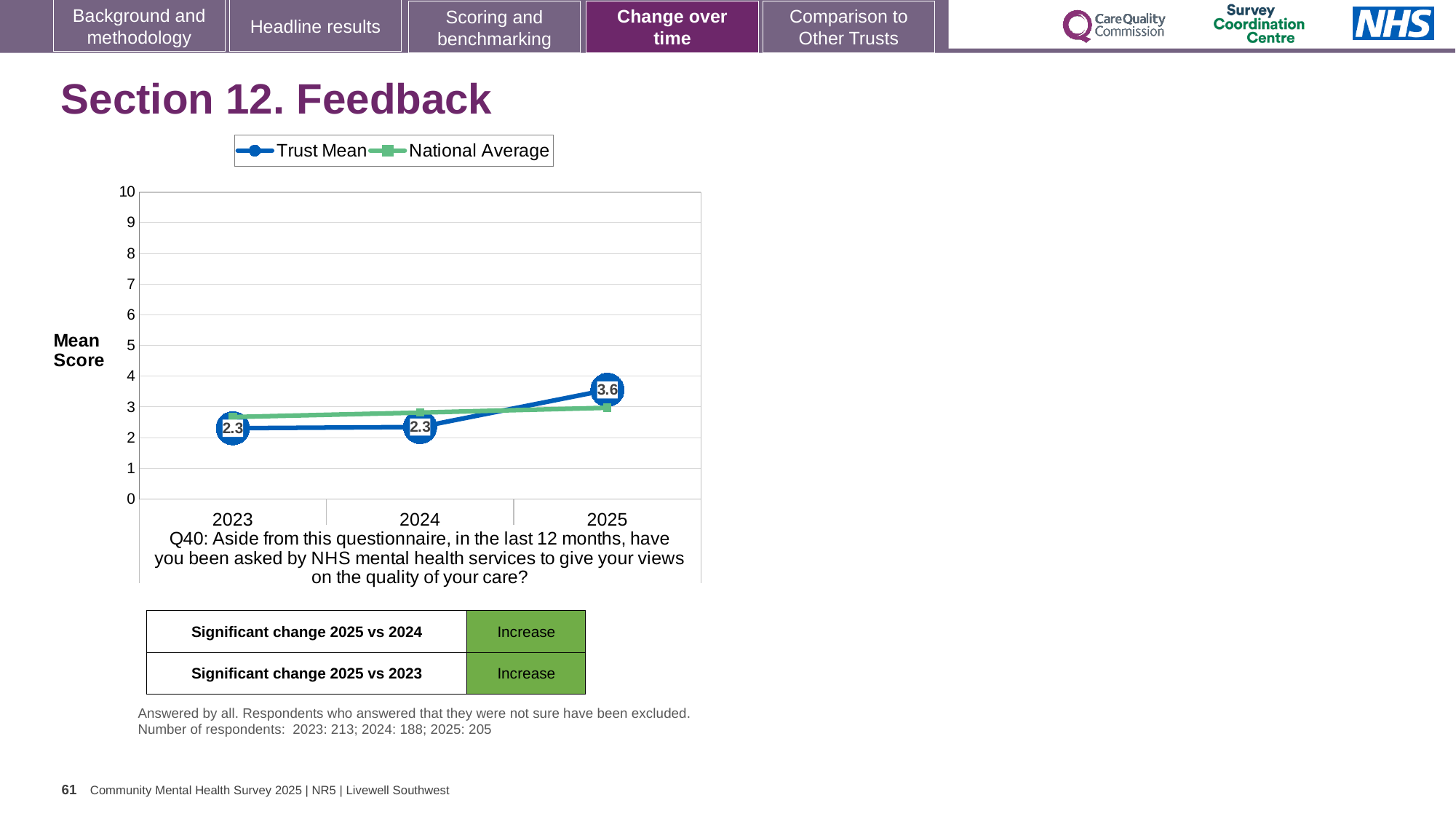
Is the National Average value for 2023 greater or less than 2? greater Does the Trust Mean rise or fall from 2024 to 2025? rise Is the National Average value for 2025 greater or less than 4? less What is the difference between the Trust Mean in 2025 and in 2024? 1.3 What is the Trust Mean score for 2023? 2.3 How many series does the legend list? 2 What kind of chart is shown on the slide? line chart What is the Trust Mean score for 2024? 2.3 Which is larger, the Trust Mean in 2025 or the Trust Mean in 2023? 2025 What is the Trust Mean score for 2025? 3.6 How many years are plotted on the x axis? 3 In which year is the Trust Mean highest? 2025